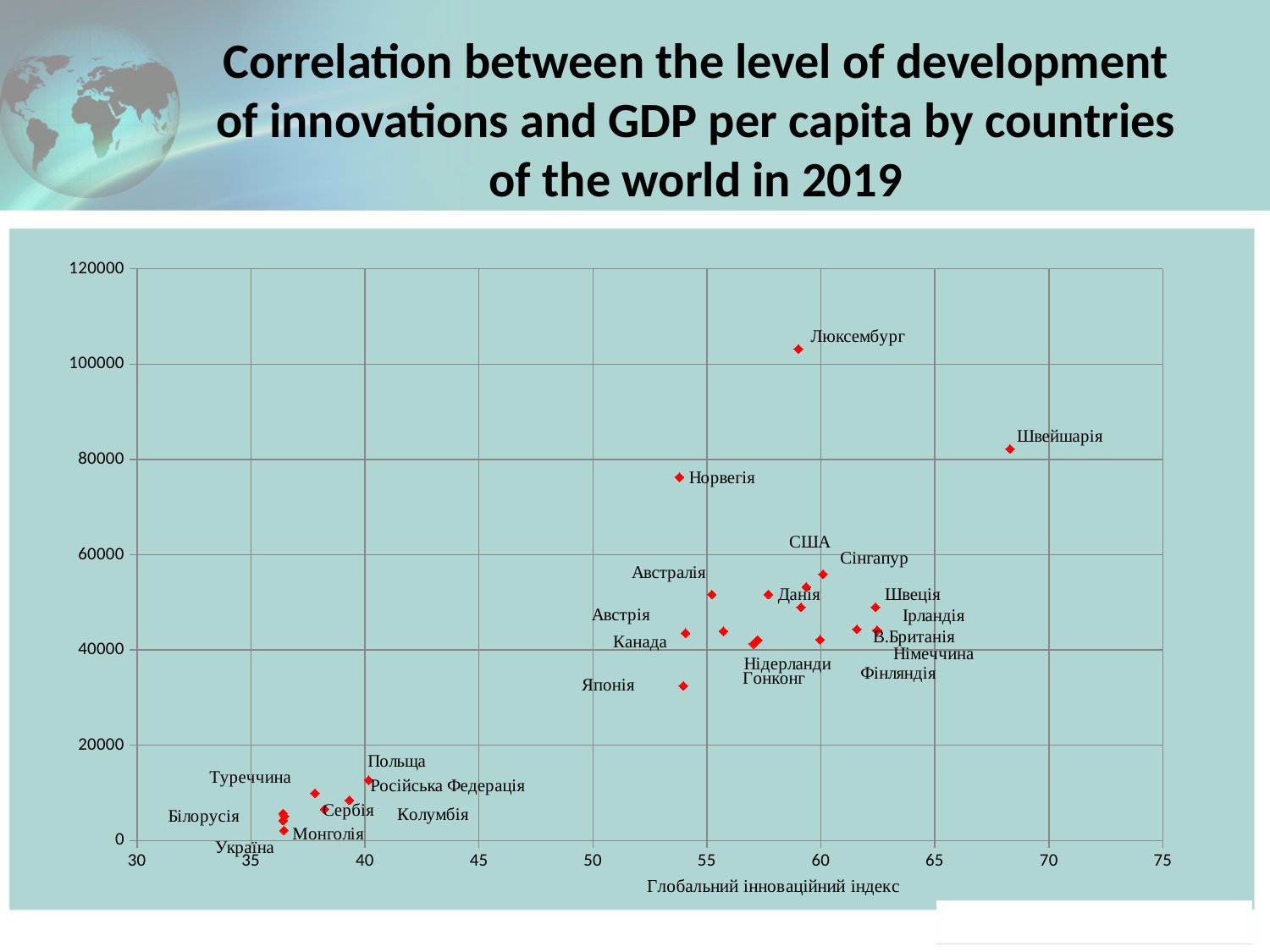
Which has the higher GDP per capita, Люксембург or Швейшарія? Люксембург Which country has the highest GDP per capita on the chart? Люксембург Is the GDP per capita value for Польща greater or less than 20000? less What is the label of the horizontal axis? Глобальний інноваційний індекс Is the GDP per capita value for Норвегія greater or less than 60000? greater Is the GDP per capita value for Люксембург greater or less than 80000? greater Which has the higher global innovation index, Швейшарія or Норвегія? Швейшарія Do GDP per capita values generally rise or fall as the global innovation index increases? Rise Which country has the highest global innovation index on the chart? Швейшарія What kind of chart is shown on the slide? Scatter chart